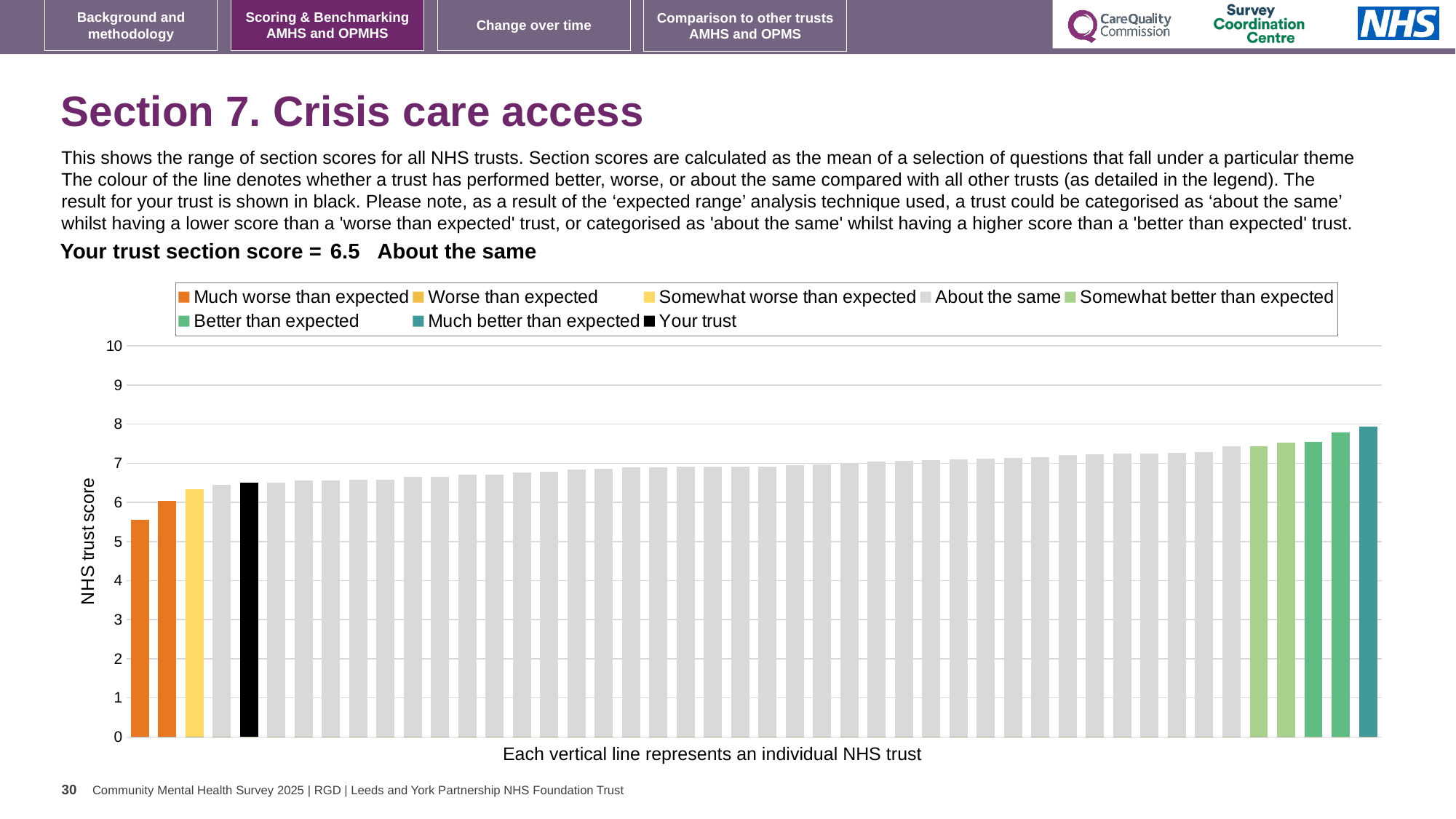
Is the value of the highest bar (rightmost trust) greater or less than 7? greater Which legend category does the highest bar belong to? Much better than expected How many bars are coloured as 'Much worse than expected'? 2 Do the bar values rise or fall from left to right along the x axis? Rise Which legend category does the lowest bar belong to? Much worse than expected How many entries does the chart legend list? 8 Which performance category is your trust placed in for this section? About the same Is the value for your trust greater or less than 7? less Is the value of the lowest bar (leftmost trust) greater or less than 6? less What kind of chart is shown on the slide? Bar chart What colour is the bar representing your trust? Black What is the section score for your trust? 6.5